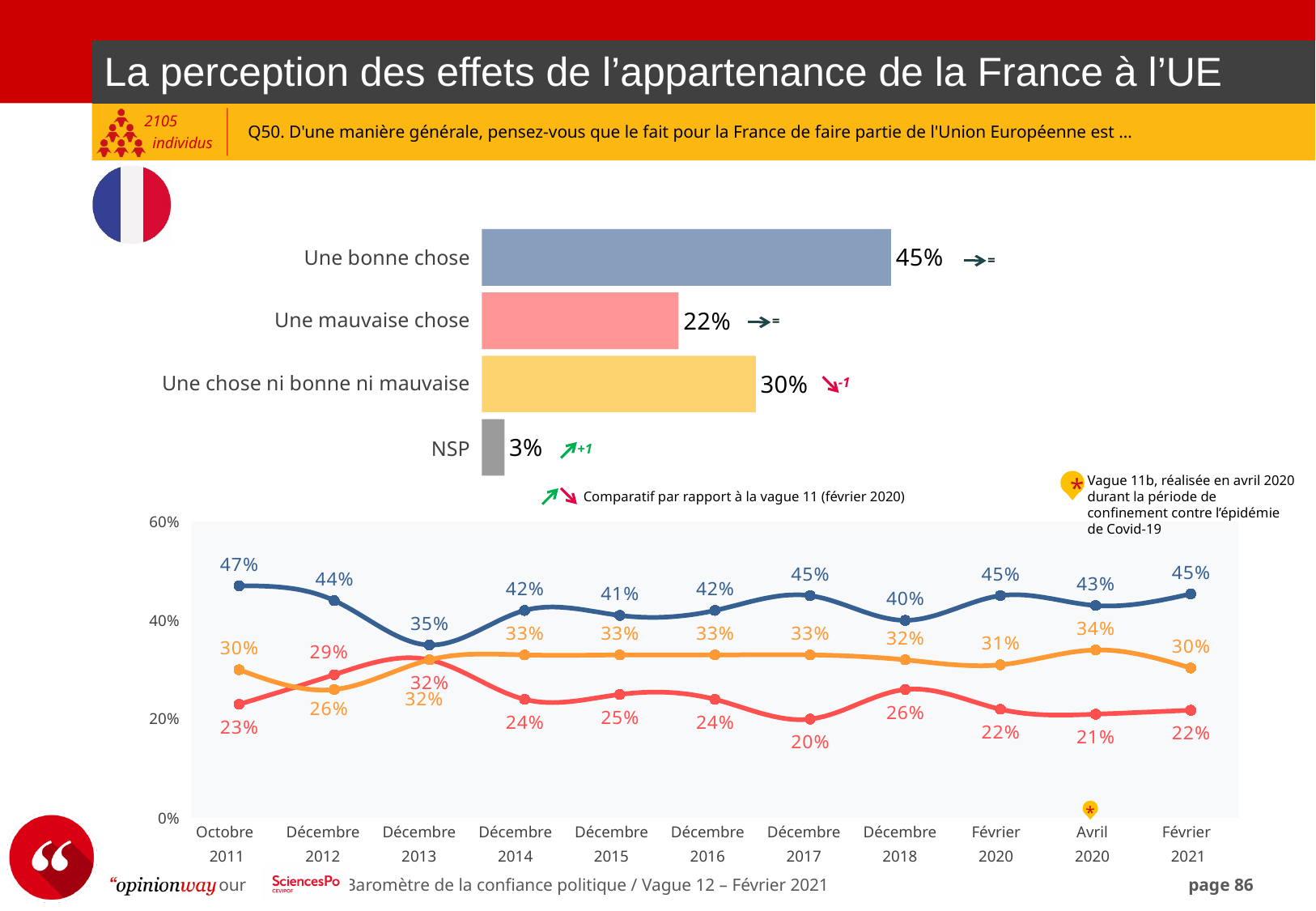
On the top bar chart, what is the value for 'NSP'? 3% On the bottom line chart, what is the difference between the blue line and the orange line in Février 2021? 15 percentage points On the bottom line chart, at which time point does the blue line reach its lowest value? Décembre 2013 On the top bar chart, which is larger: 'Une mauvaise chose' or 'Une chose ni bonne ni mauvaise'? Une chose ni bonne ni mauvaise On the top bar chart, what is the value for 'Une bonne chose'? 45% On the bottom line chart, how many time points are shown on the x axis? 11 On the top bar chart, which category has the highest value? Une bonne chose On the bottom line chart, what is the value of the red line for Décembre 2017? 20% What kind of chart is the top chart on the slide? Bar chart On the top bar chart, which category has the lowest value? NSP On the top bar chart, what is the difference between 'Une bonne chose' and 'Une mauvaise chose'? 23 percentage points On the bottom line chart, what is the value of the blue line for Octobre 2011? 47%